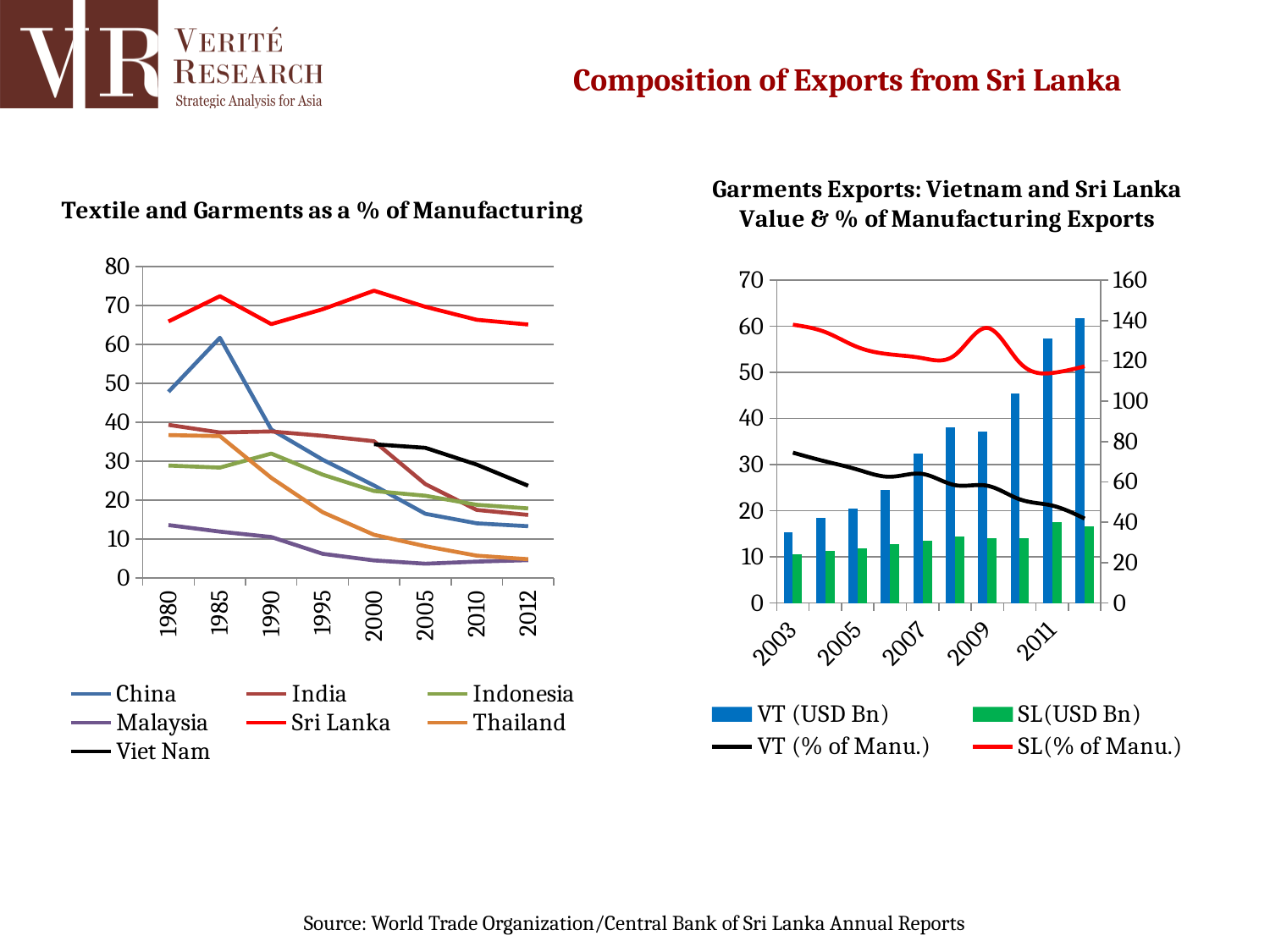
In the 'Garments Exports: Vietnam and Sri Lanka' chart, do the VT (USD Bn) bars rise or fall from 2003 to 2012? rise In the 'Textile and Garments as a % of Manufacturing' chart, does the value for Thailand rise or fall from 1980 to 2012? fall In the 'Textile and Garments as a % of Manufacturing' chart, which is larger in 1985, China or India? China In the 'Textile and Garments as a % of Manufacturing' chart, which country has the lowest value in 1980? Malaysia In the 'Textile and Garments as a % of Manufacturing' chart, is the value for Sri Lanka in 1980 greater or less than 60? greater In the 'Textile and Garments as a % of Manufacturing' chart, which country has the highest value in 2012? Sri Lanka In the 'Textile and Garments as a % of Manufacturing' chart, is the value for China in 1980 greater or less than 50? less In the 'Garments Exports: Vietnam and Sri Lanka' chart, which series is shown with a red line? SL(% of Manu.) How many series does the legend of the 'Textile and Garments as a % of Manufacturing' chart list? 7 How many series does the legend of the 'Garments Exports: Vietnam and Sri Lanka' chart list? 4 What kind of chart is the 'Textile and Garments as a % of Manufacturing' chart? line chart In the 'Garments Exports: Vietnam and Sri Lanka' chart, is the VT (USD Bn) value for 2011 greater or less than 50? greater